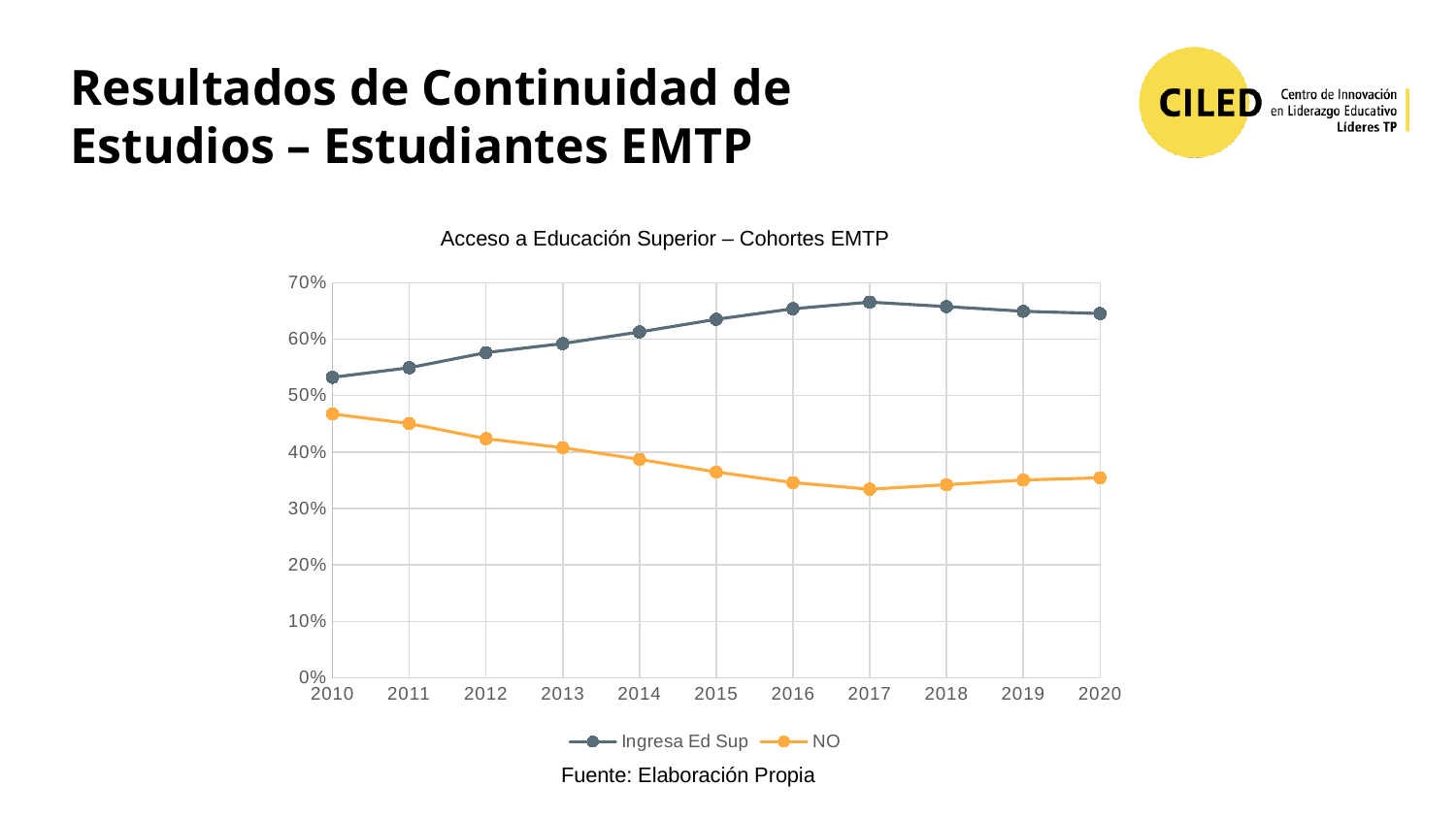
What is the title of the chart? Acceso a Educación Superior – Cohortes EMTP How many years are plotted along the x axis? 11 In which year is the value for Ingresa Ed Sup highest? 2017 Which series is drawn in orange? NO What kind of chart is shown on the slide? Line chart In which year is the value for NO highest? 2010 Is the value for Ingresa Ed Sup in 2010 greater or less than 50%? greater In which year is the value for Ingresa Ed Sup lowest? 2010 Does the value for NO generally rise or fall from 2010 to 2017? Fall How many series does the legend list? 2 Which series has the larger value in 2010, Ingresa Ed Sup or NO? Ingresa Ed Sup Is the value for NO in 2017 greater or less than 40%? less